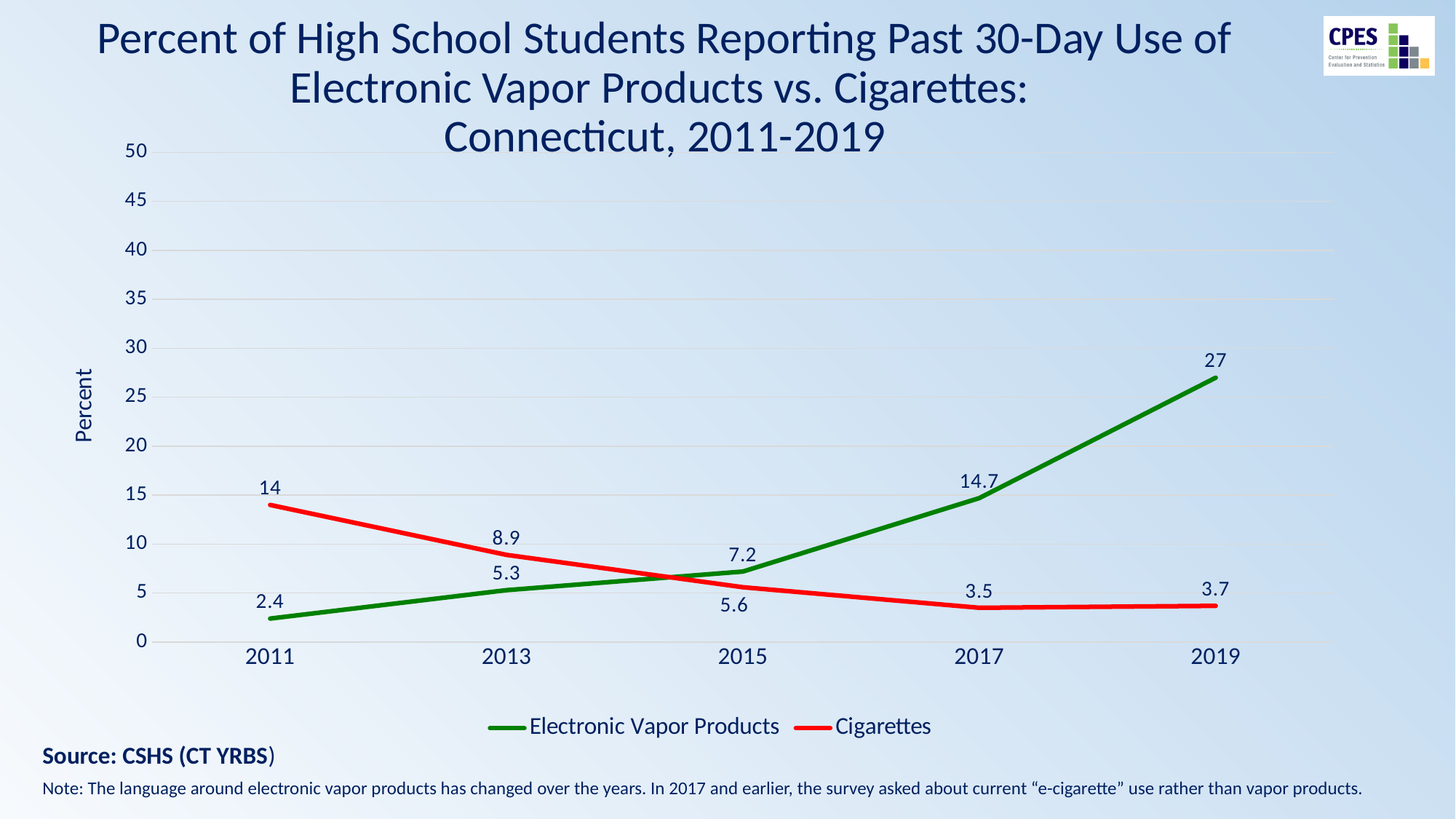
In which year was the Cigarettes value lowest? 2017 What was the value for Cigarettes in 2017? 3.5 In 2013, which was larger: the Electronic Vapor Products value or the Cigarettes value? Cigarettes How many years are plotted on the x axis? 5 What was the percent of high school students reporting past 30-day use of Electronic Vapor Products in 2019? 27 What was the value for Electronic Vapor Products in 2015? 7.2 In which year was the Electronic Vapor Products value highest? 2019 Does the Cigarettes value rise or fall from 2011 to 2017? Fall What was the percent of high school students reporting past 30-day use of Cigarettes in 2011? 14 What is the difference between the Electronic Vapor Products value and the Cigarettes value in 2019? 23.3 What kind of chart is shown on the slide? Line chart How many series does the legend list? 2